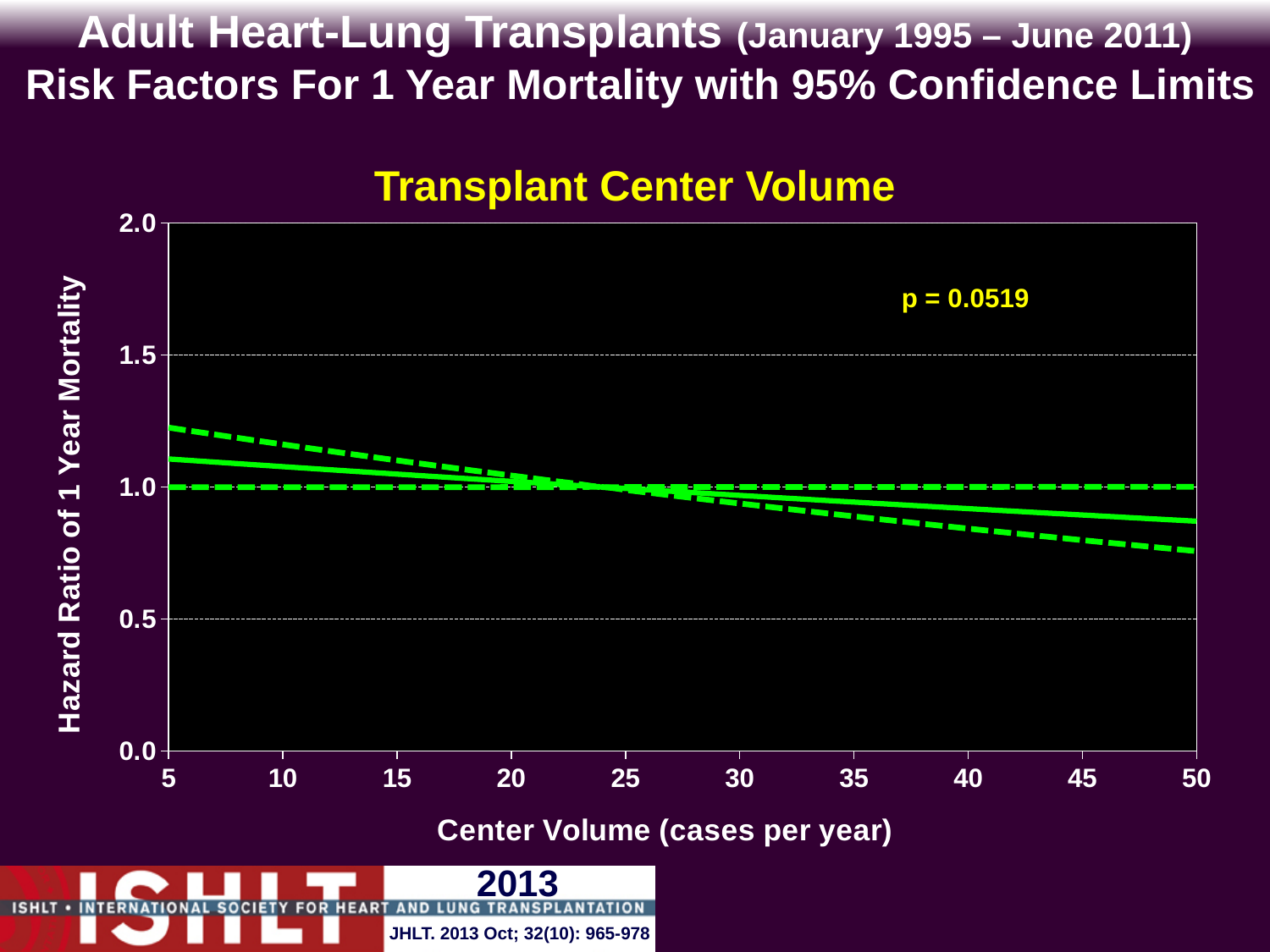
What is the label of the x axis? Center Volume (cases per year) Is the hazard ratio on the solid line higher at a center volume of 5 or at a center volume of 50 cases per year? 5 What is the highest value shown on the y axis? 2.0 What is the title of the chart? Transplant Center Volume Is the upper dashed confidence limit at a center volume of 5 cases per year greater or less than 1.5? less What kind of chart is shown on the slide? line chart Is the lower dashed confidence limit at a center volume of 50 cases per year greater or less than 0.5? greater Does the solid hazard ratio line rise or fall as center volume increases along the x axis? fall Is the hazard ratio on the solid line at a center volume of 5 cases per year greater or less than 1.0? greater How many tick labels are shown on the x axis? 10